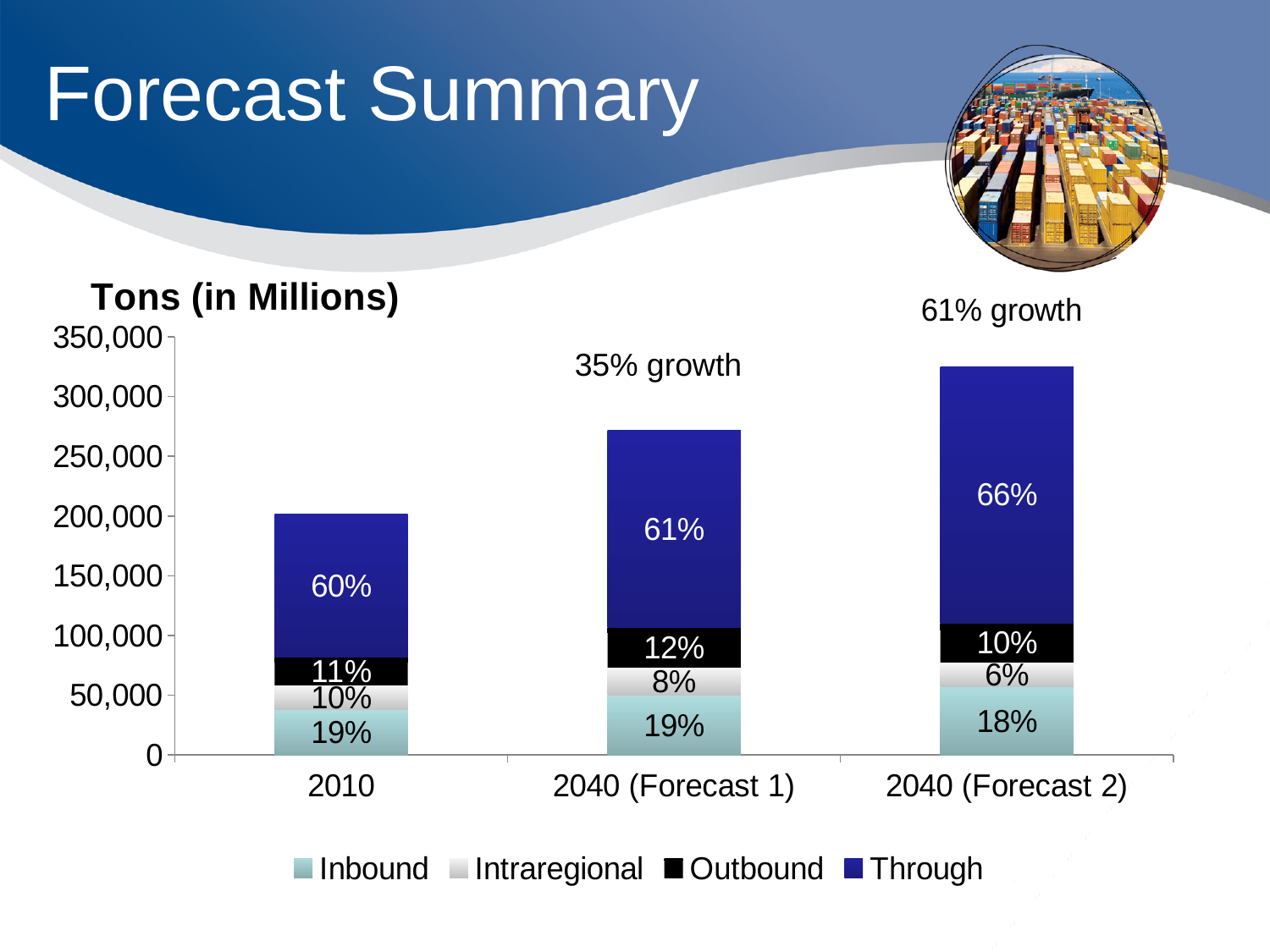
Which category has the tallest total bar? 2040 (Forecast 2) What percentage label is shown for the Outbound segment in 2040 (Forecast 2)? 10% What growth annotation is shown above the 2040 (Forecast 1) bar? 35% growth Is the total bar for 2040 (Forecast 1) greater or less than 250,000? greater How many categories are shown on the x axis? 3 What percentage label is shown for the Inbound segment in 2040 (Forecast 2)? 18% What percentage label is shown for the Intraregional segment in 2040 (Forecast 1)? 8% How many series does the legend list? 4 Is the total bar for 2040 (Forecast 2) greater or less than 300,000? greater What percentage label is shown for the Through segment in 2010? 60% Which category has the shortest total bar? 2010 What kind of chart is shown on the slide? Stacked bar chart